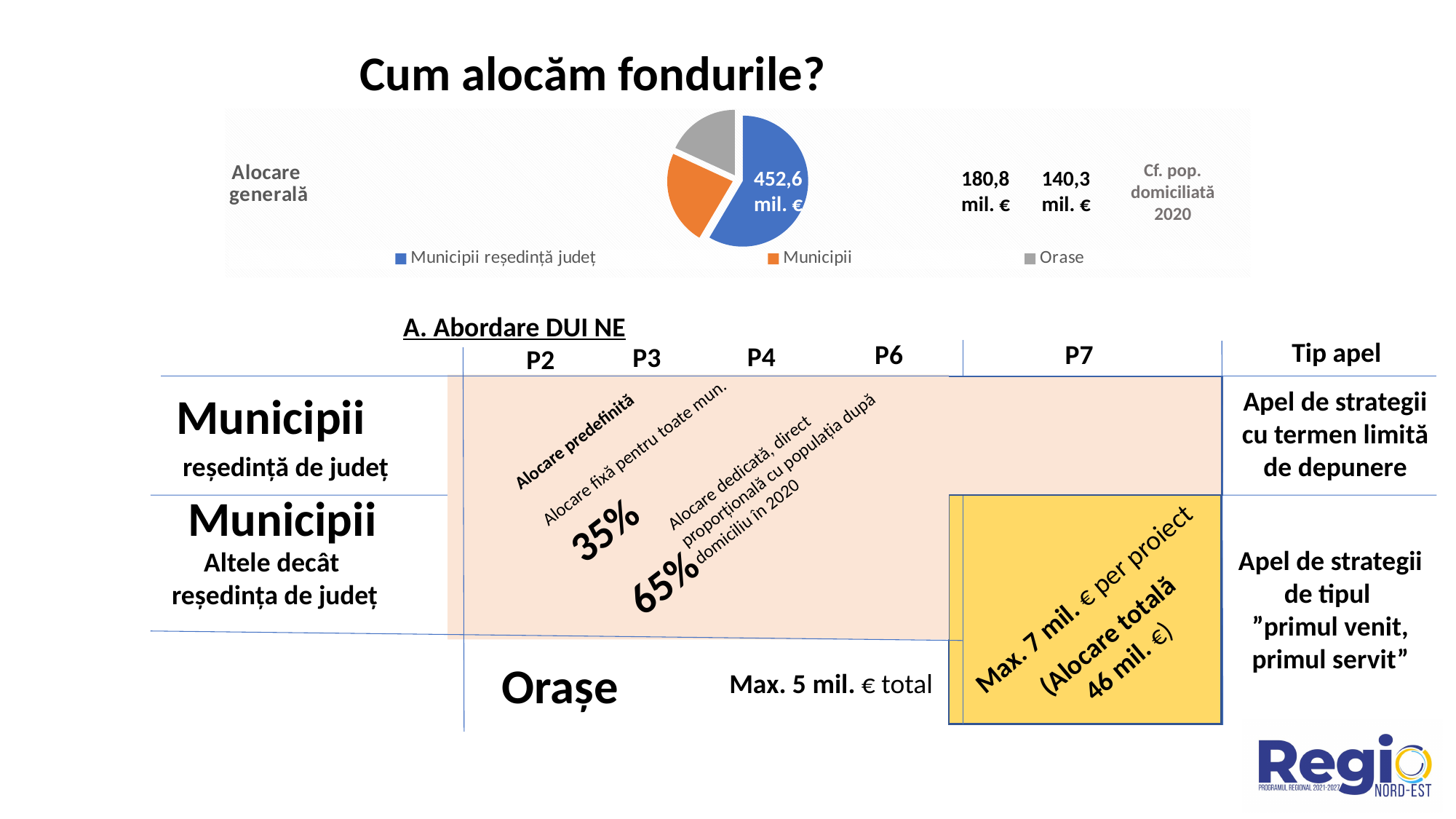
In the pie chart, which slice is larger: Municipii or Orase? Municipii What label appears to the left of the pie chart? Alocare generală What kind of chart is shown at the top of the slide under the title "Cum alocăm fondurile?"? pie chart How many entries does the legend of the pie chart list? 3 What value is shown for the Municipii (orange) slice of the pie chart? 180,8 mil. € What value is printed on the blue slice (Municipii reședință județ) of the pie chart? 452,6 mil. € What colour is the Municipii reședință județ slice in the pie chart? blue What is the difference between the Municipii reședință județ value (452,6 mil. €) and the Municipii value (180,8 mil. €) in the pie chart? 271,8 mil. € What value is shown for the Orase (gray) slice of the pie chart? 140,3 mil. € Which category has the smallest slice in the pie chart? Orase How many slices does the pie chart have? 3 Which category has the largest slice in the pie chart? Municipii reședință județ